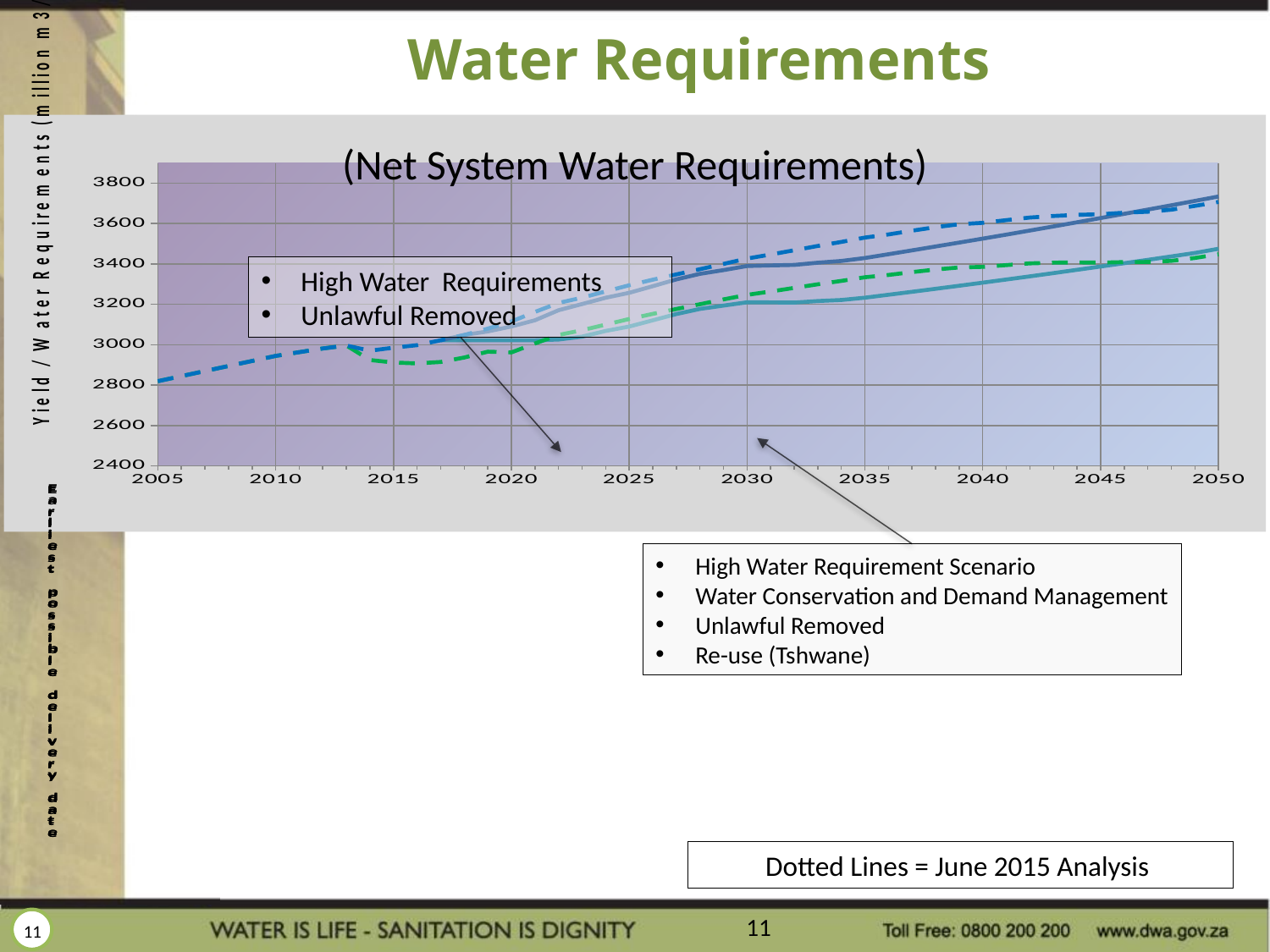
Is the value of the green dotted line at 2015 greater or less than 3000? less What kind of chart is shown on the slide? line chart According to the note on the slide, what do the dotted lines in the chart represent? June 2015 Analysis At 2050, which is larger: the upper solid line or the lower solid line? the upper solid line Is the value of the topmost solid line at 2035 greater or less than 3200? greater Is the value of the lower solid line at 2050 greater or less than 3400? greater Do the plotted lines generally rise or fall from 2005 to 2050? rise What is the title shown above the chart's plot area? (Net System Water Requirements) What is the first year shown on the x axis of the chart? 2005